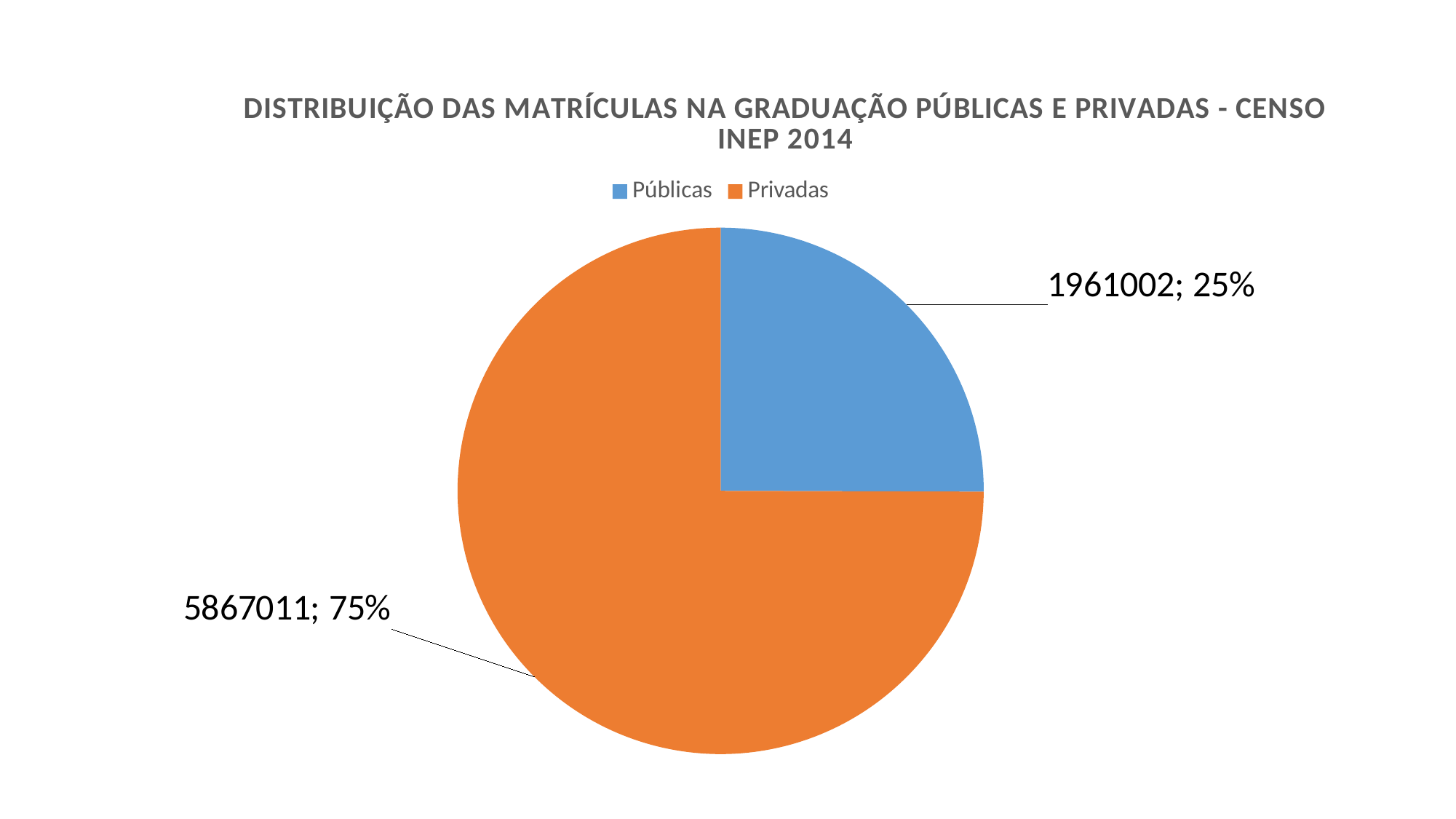
What is the total of the two slices? 7828013 What colour is the Privadas slice? orange What is the value for Privadas? 5867011 What is the difference between the values for Privadas and Públicas? 3906009 What share of the pie does Privadas represent? 75% What type of chart is shown on the slide? pie chart How many categories does the pie chart have? 2 What share of the pie does Públicas represent? 25% Which is larger, Públicas or Privadas? Privadas Which category has the largest slice? Privadas Which category has the smallest slice? Públicas What is the value for Públicas? 1961002